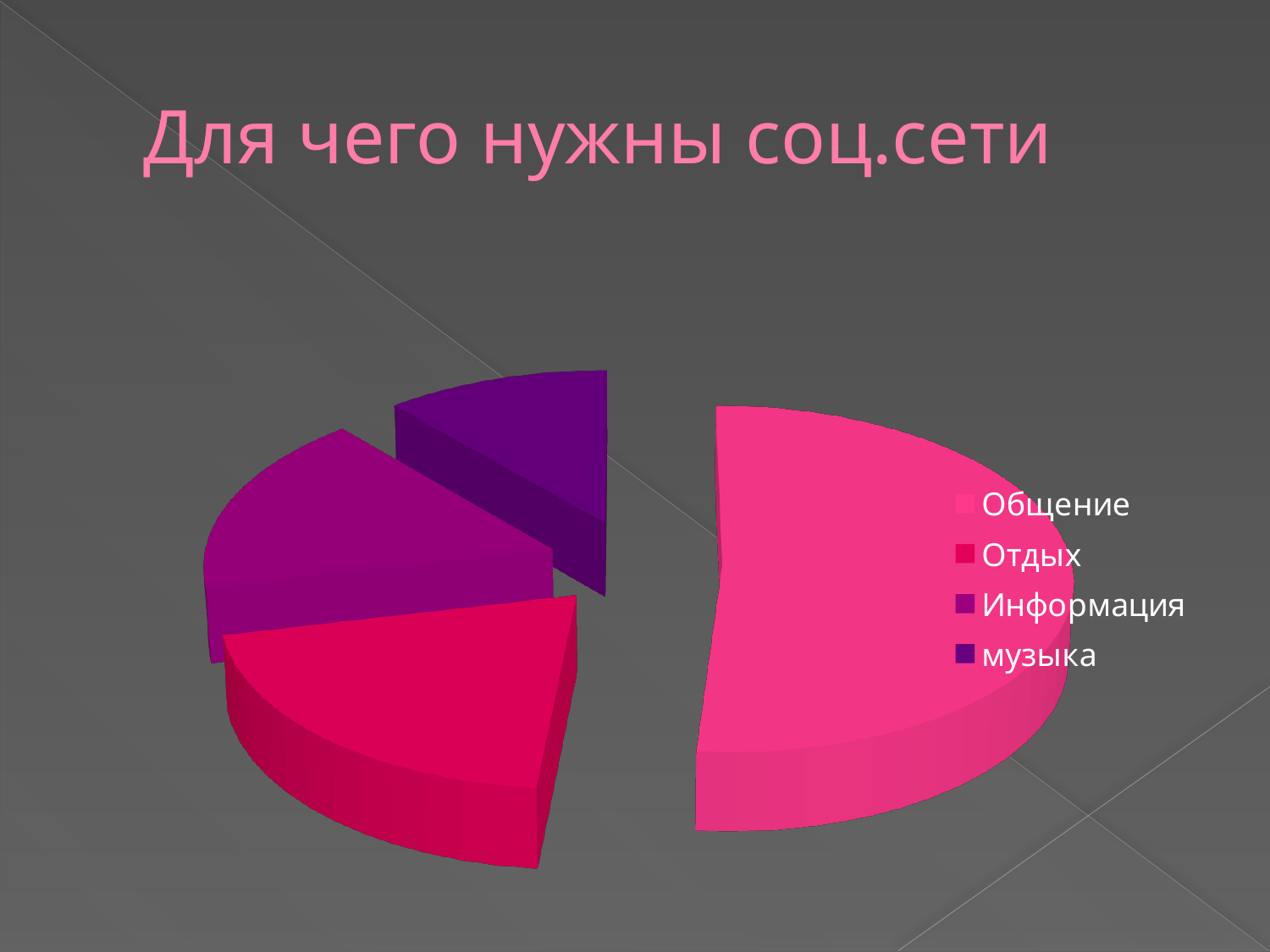
Which slice is larger, Отдых or музыка? Отдых Which category has the smallest slice of the pie chart? музыка What is the title of the slide containing the pie chart? Для чего нужны соц.сети What kind of chart is shown on the slide? pie chart Which slice is larger, Информация or музыка? Информация Which categories are listed in the legend of the pie chart? Общение, Отдых, Информация, музыка Which slice is larger, Общение or Отдых? Общение How many slices does the pie chart have? 4 Which category has the largest slice of the pie chart? Общение